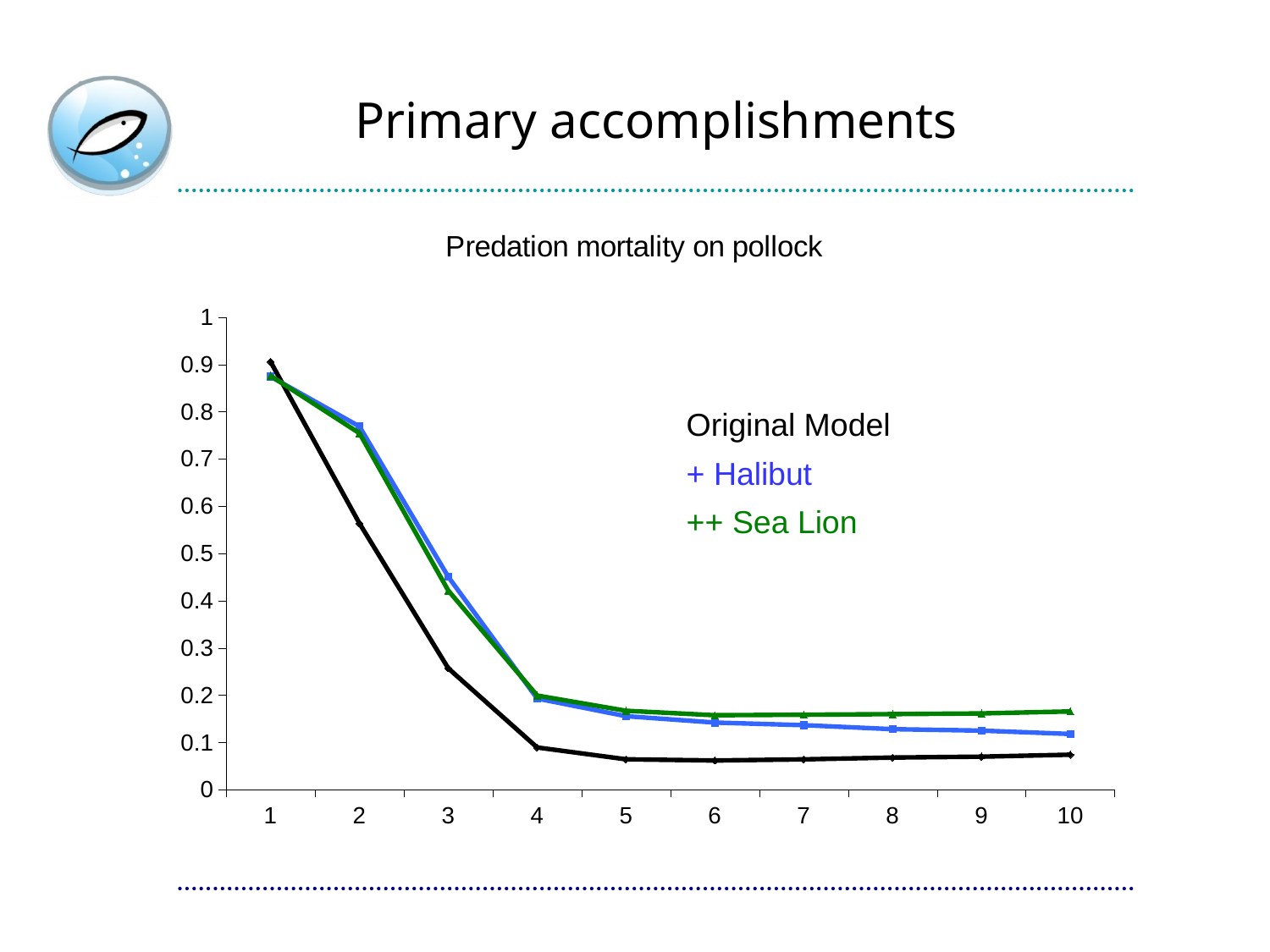
Is the value for + Halibut at x = 3 greater or less than 0.5? less What kind of chart is shown on the slide? line chart At x = 10, which is larger: ++ Sea Lion or the Original Model? ++ Sea Lion At which x value does the Original Model series reach its highest value? 1 Is the value for the Original Model at x = 5 greater or less than 0.1? less Do the values for the Original Model series rise or fall from x = 1 to x = 4? fall How many points are plotted along the x axis for each series? 10 Is the value for the Original Model at x = 2 greater or less than 0.5? greater At x = 3, which is larger: the Original Model or + Halibut? + Halibut What is the title of the chart? Predation mortality on pollock How many series does the legend list? 3